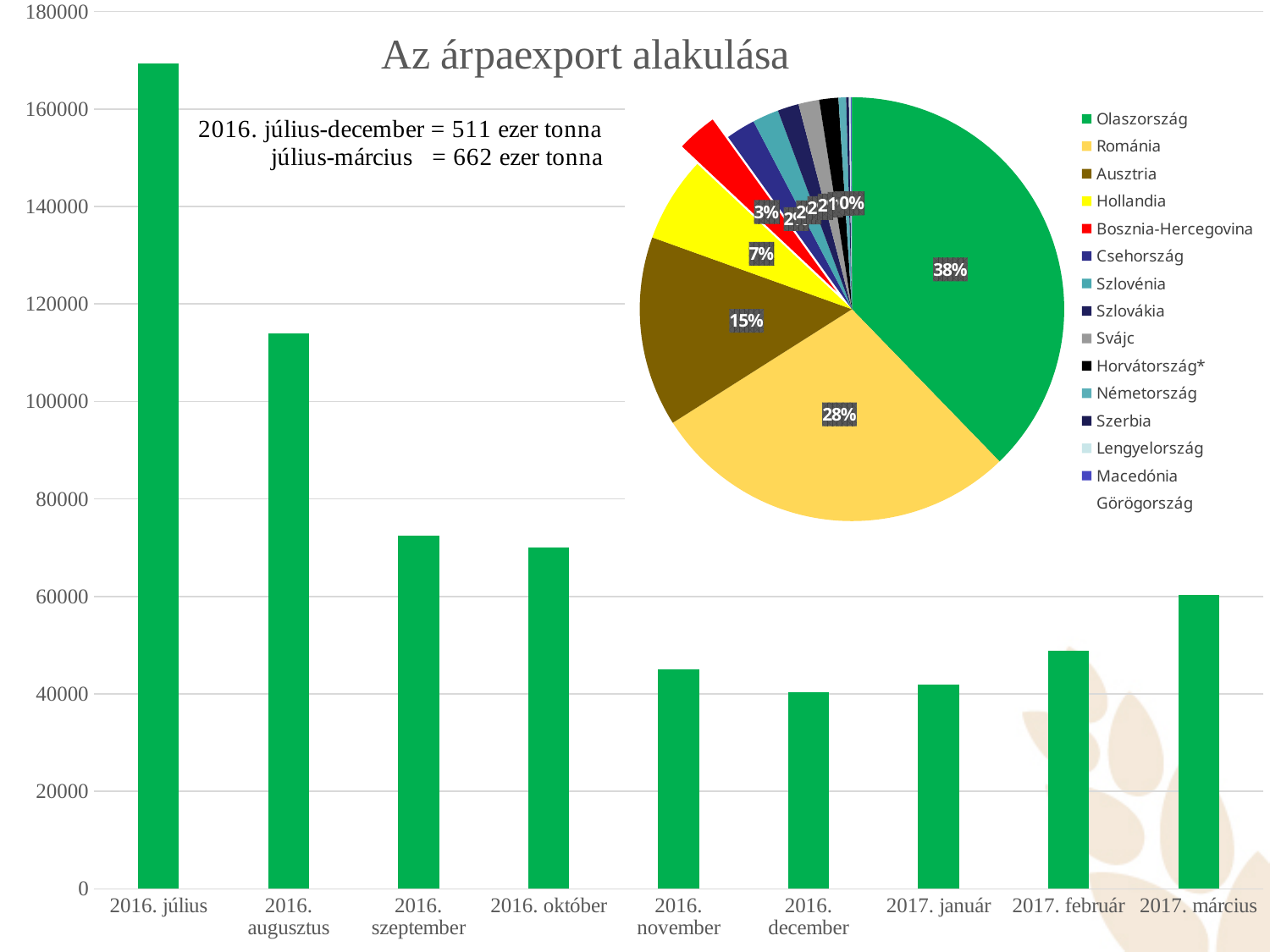
How many countries does the pie chart's legend list? 15 On the bar chart, is the value for 2016. szeptember greater or less than 80000? less On the pie chart, what is the difference between the shares of Olaszország and Románia? 10 percentage points On the bar chart, is the value for 2017. február greater or less than 60000? less On the bar chart, how many months are shown on the x axis? 9 On the pie chart, what share does Ausztria have? 15% On the bar chart, is the value for 2016. augusztus greater or less than 100000? greater On the pie chart, what share does Olaszország have? 38% On the bar chart, which month has the highest barley export? 2016. július On the bar chart, do the values rise or fall from 2016. július to 2016. december? fall On the bar chart, which is larger, the value for 2016. október or the value for 2016. november? 2016. október